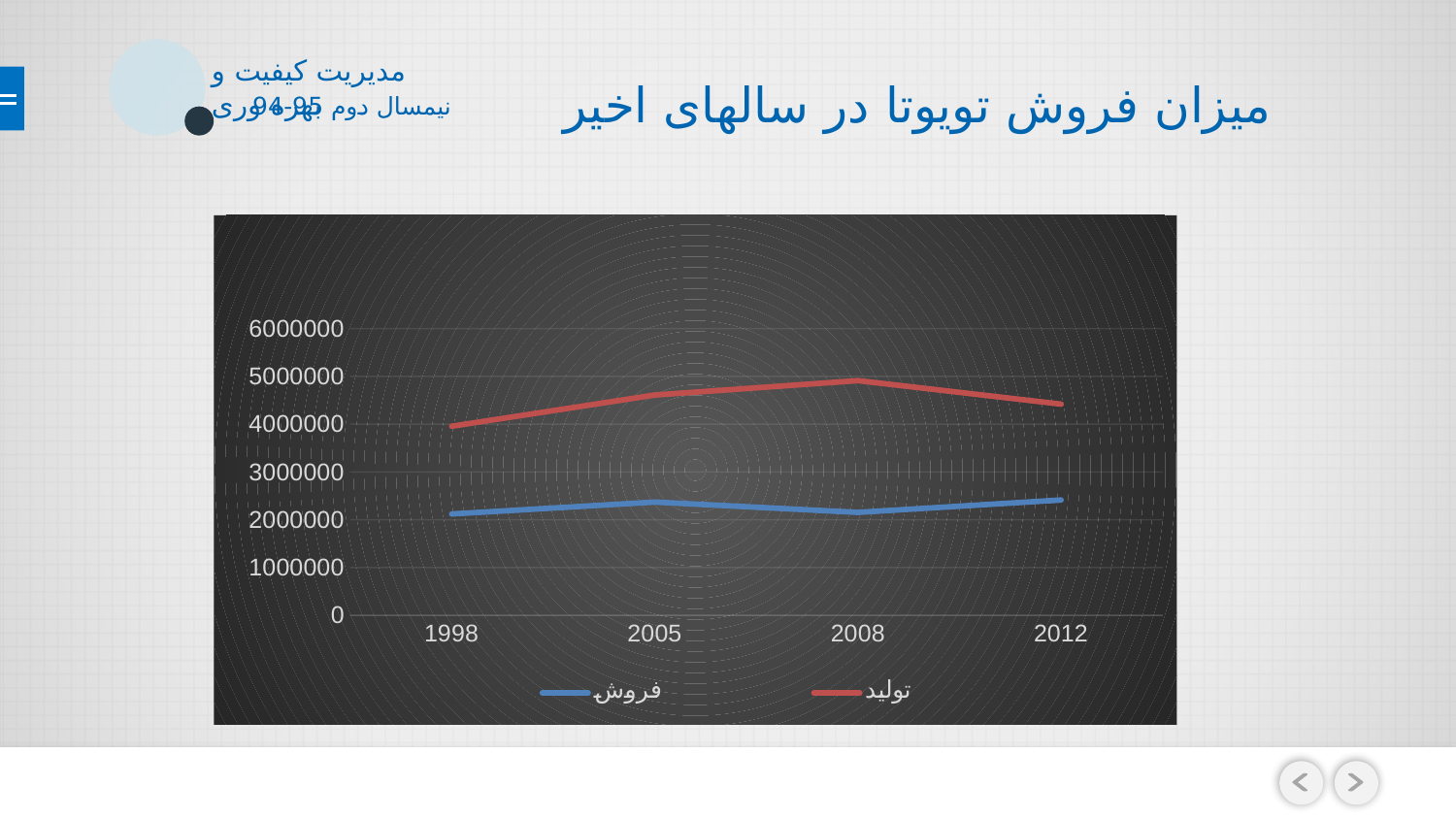
What kind of chart is shown on the slide? line chart Which series has the larger value in 2012, فروش or تولید? تولید Does the value for تولید rise or fall from 2008 to 2012? fall Does the value for تولید rise or fall from 1998 to 2008? rise How many years are shown on the x axis? 4 How many series does the legend list? 2 Which series is drawn in red? تولید Which year has the highest value for تولید? 2008 Is the value for فروش in 1998 greater or less than 3000000? less Which year has the lowest value for تولید? 1998 Is the value for تولید in 2008 greater or less than 4000000? greater Is the value for تولید in 1998 greater or less than 5000000? less